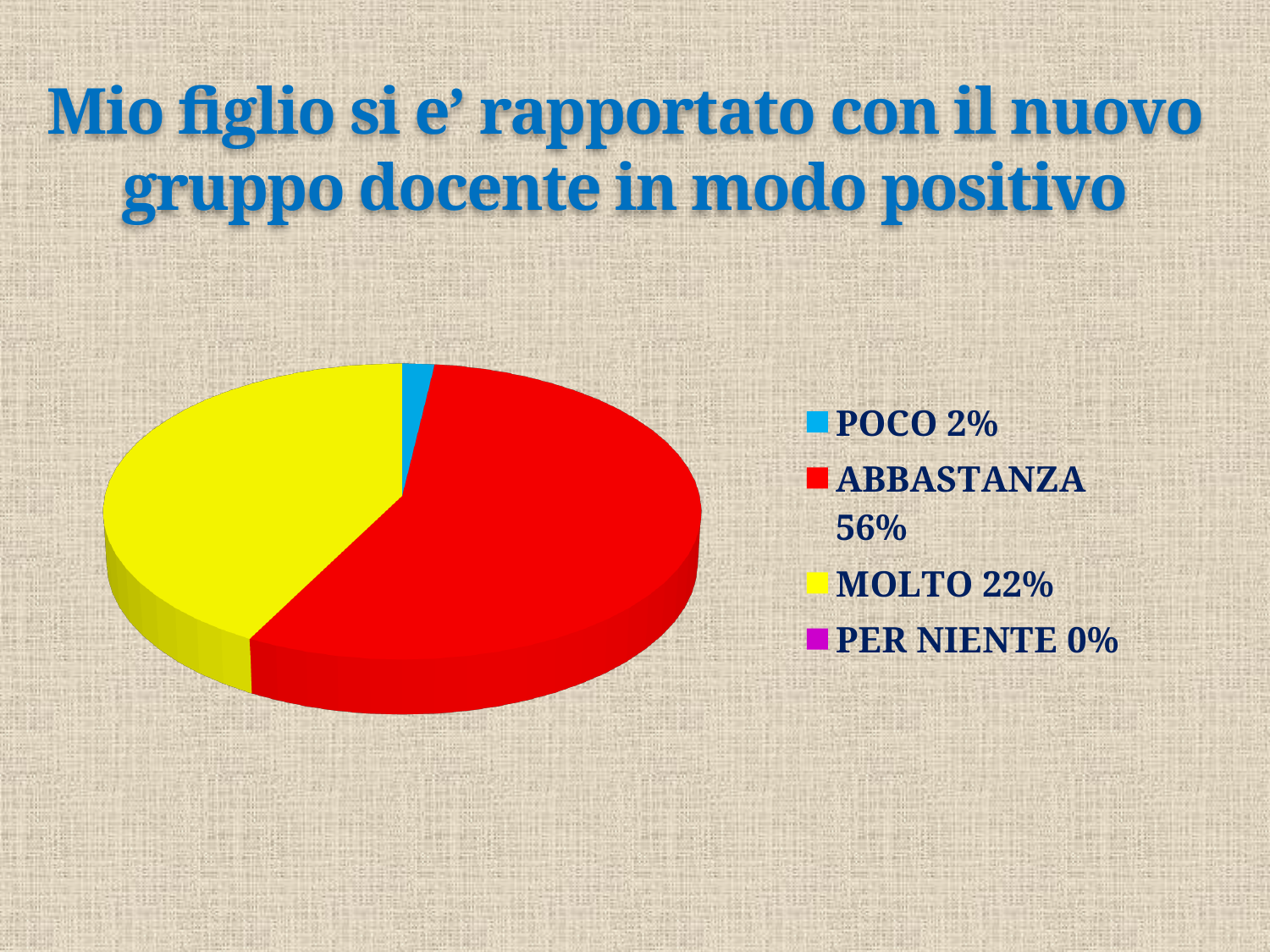
What percentage is shown for PER NIENTE? 0% Which is larger, the share for ABBASTANZA or the share for MOLTO? ABBASTANZA Which is larger, the share for POCO or the share for MOLTO? MOLTO What percentage is shown for ABBASTANZA? 56% What percentage is shown for POCO? 2% What is the title of the chart slide? Mio figlio si e' rapportato con il nuovo gruppo docente in modo positivo Which category has the smallest share according to the legend? PER NIENTE What percentage is shown for MOLTO? 22% What colour represents ABBASTANZA in the pie chart? red Which category has the largest share of the pie? ABBASTANZA What kind of chart is shown on the slide? pie chart How many categories does the legend list? 4